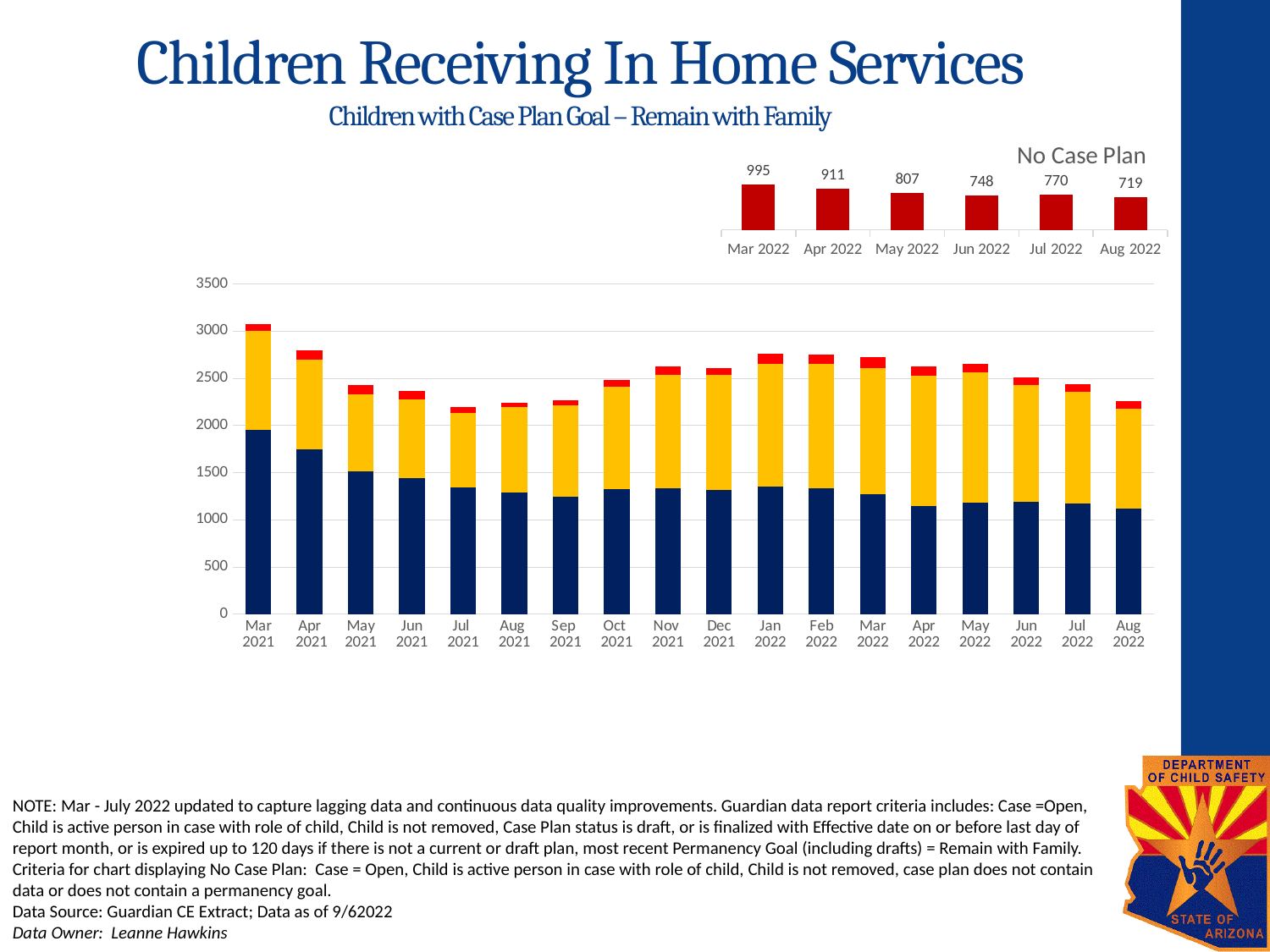
In the No Case Plan chart, what is the difference between the Mar 2022 and Aug 2022 values? 276 How many months are shown on the x axis of the large stacked bar chart? 18 In the No Case Plan chart, which month has the lowest value? Aug 2022 What kind of chart is the large chart at the bottom of the slide? Stacked bar chart In the No Case Plan chart, what is the value for Jun 2022? 748 In the No Case Plan chart, which is larger, the value for Jun 2022 or Jul 2022? Jul 2022 How many months are shown in the No Case Plan chart? 6 In the No Case Plan chart, which month has the highest value? Mar 2022 In the large stacked bar chart, is the total for Aug 2022 greater or less than 2500? less In the large stacked bar chart, is the total for Mar 2021 greater or less than 3000? greater In the No Case Plan chart, what is the value for Mar 2022? 995 In the large stacked bar chart, do the totals rise or fall from Mar 2021 to Jul 2021? fall